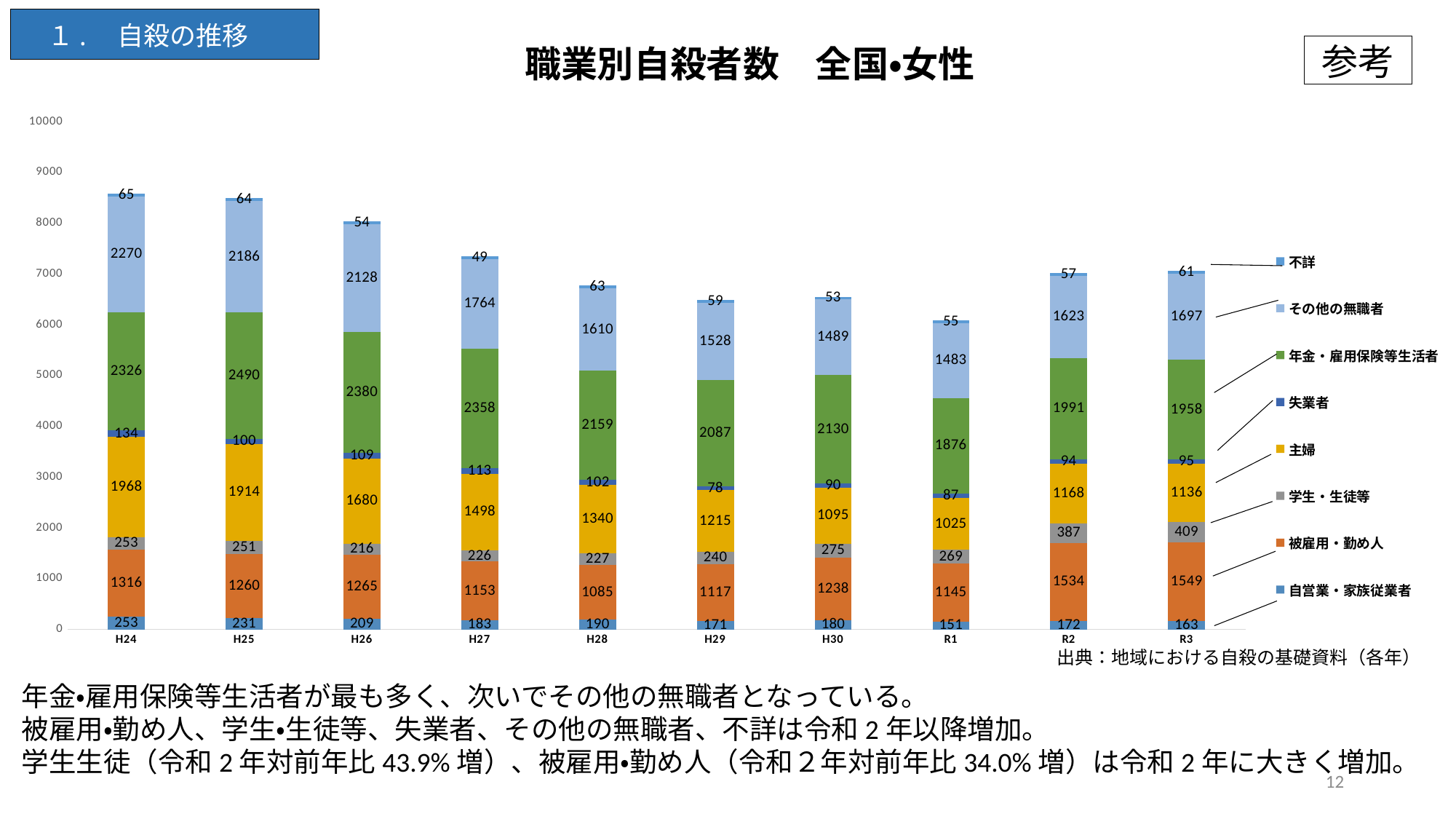
Does the value for 主婦 rise or fall from H24 to R1? Fall Which is larger, the その他の無職者 value for H24 or for H25? H24 What is the value for 不詳 in H26? 54 In which year is the value for 年金・雇用保険等生活者 the highest? H25 What is the value for 主婦 in H24? 1968 How many series does the legend list? 8 What is the value for 被雇用・勤め人 in R2? 1534 In which year is the value for 自営業・家族従業者 the lowest? R1 How many years are shown on the x axis? 10 What is the difference between the 学生・生徒等 values for R2 and R1? 118 What kind of chart is shown on the slide? Stacked bar chart What is the total of the stacked bar for H24? 8585